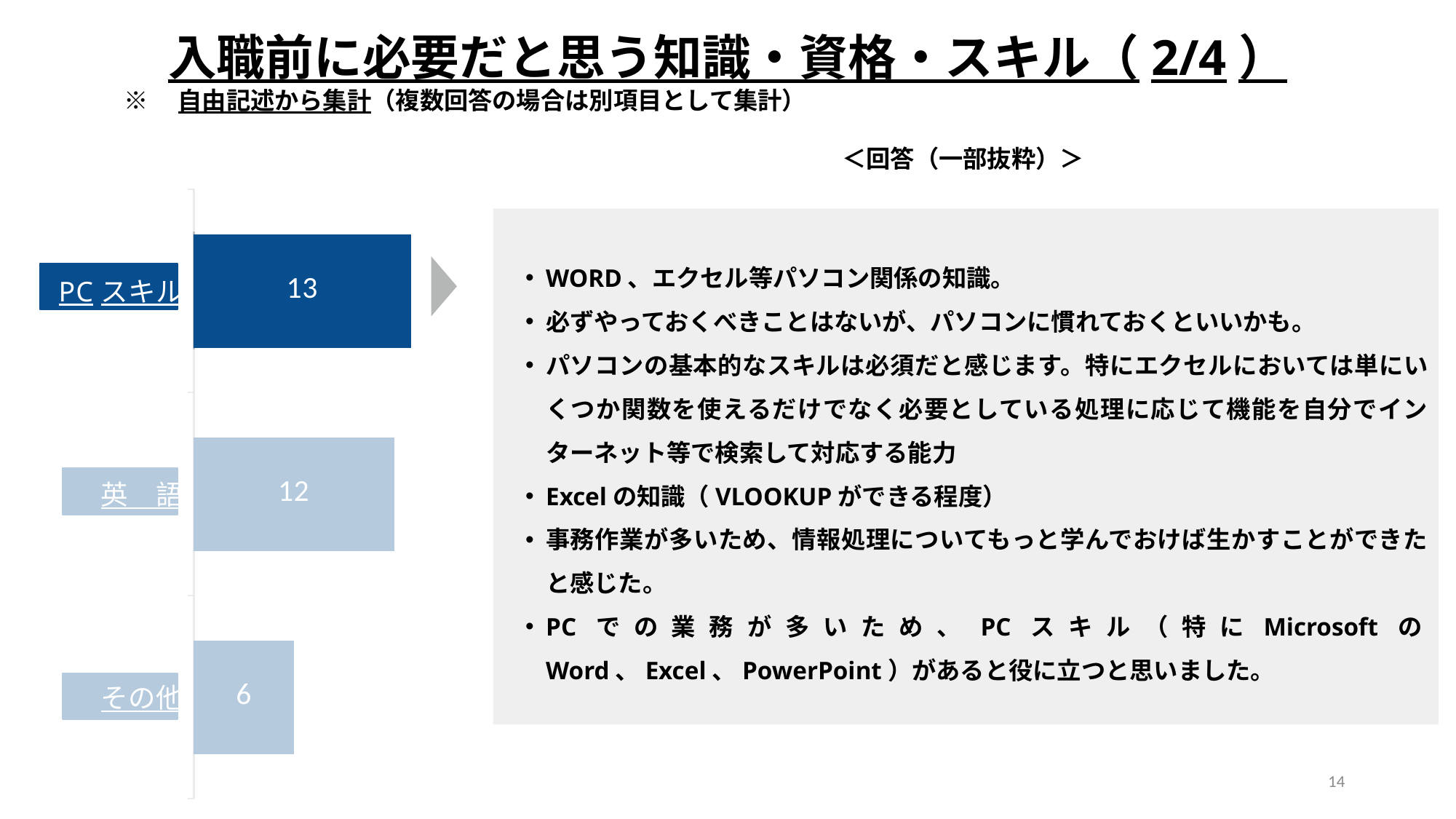
Which bar is drawn in a darker blue than the others? PC スキル What is the difference between the values for PC スキル and その他? 7 What is the value for PC スキル? 13 What kind of chart is shown on the slide? bar chart Are the bars in the chart horizontal or vertical? horizontal What is the difference between the values for PC スキル and 英語? 1 Which is larger, the value for 英語 or the value for その他? 英語 What is the value for その他? 6 What is the value for 英語? 12 Which category has the highest value? PC スキル How many categories are shown in the chart? 3 Which category has the lowest value? その他